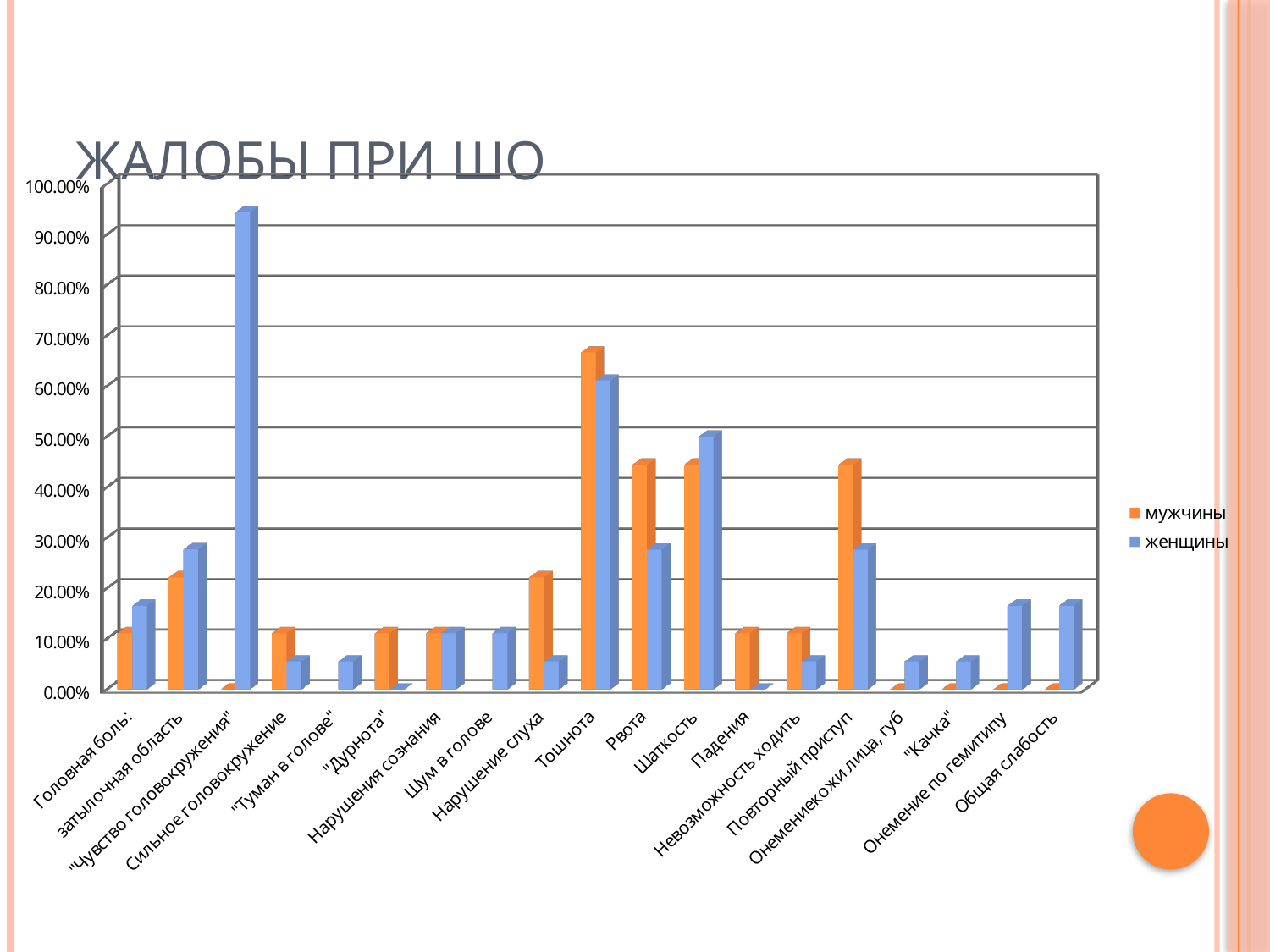
For Шаткость, which series has the larger value, мужчины or женщины? женщины For which category is the женщины value highest? "Чувство головокружения" For Повторный приступ, which series has the larger value, мужчины or женщины? мужчины What is the title of the chart? ЖАЛОБЫ ПРИ ШО For which category is the мужчины value highest? Тошнота Is the женщины value for "Чувство головокружения" greater or less than 90.00%? greater What kind of chart is shown on the slide? bar chart Is the мужчины value for Тошнота greater or less than 60.00%? greater Which series is shown in orange? мужчины How many complaint categories are shown on the x axis? 19 How many series does the legend list? 2 Is the мужчины value for Рвота greater or less than 40.00%? greater